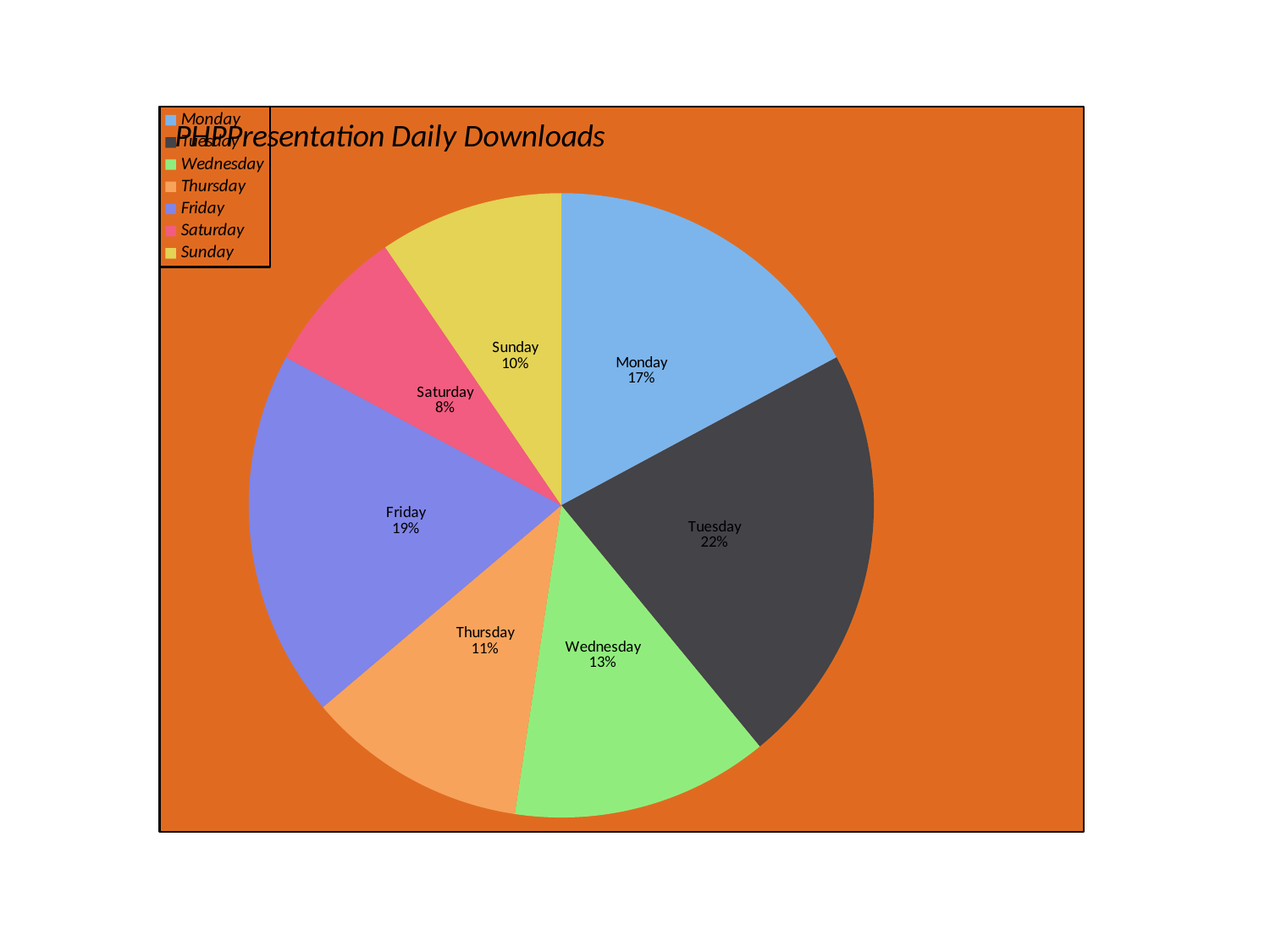
What share of the pie does Tuesday have? 22% How many slices does the pie chart have? 7 Which day has the largest slice of the pie? Tuesday What is the title of the chart? PHPPresentation Daily Downloads What percentage is shown for Wednesday? 13% What colour is the Friday slice? purple Which day has the smallest slice of the pie? Saturday What percentage is shown for Saturday? 8% What is the difference in percentage points between Tuesday and Sunday? 12 Which is larger, the slice for Monday or the slice for Thursday? Monday What share of the pie does Friday have? 19% What kind of chart is shown on the slide? pie chart